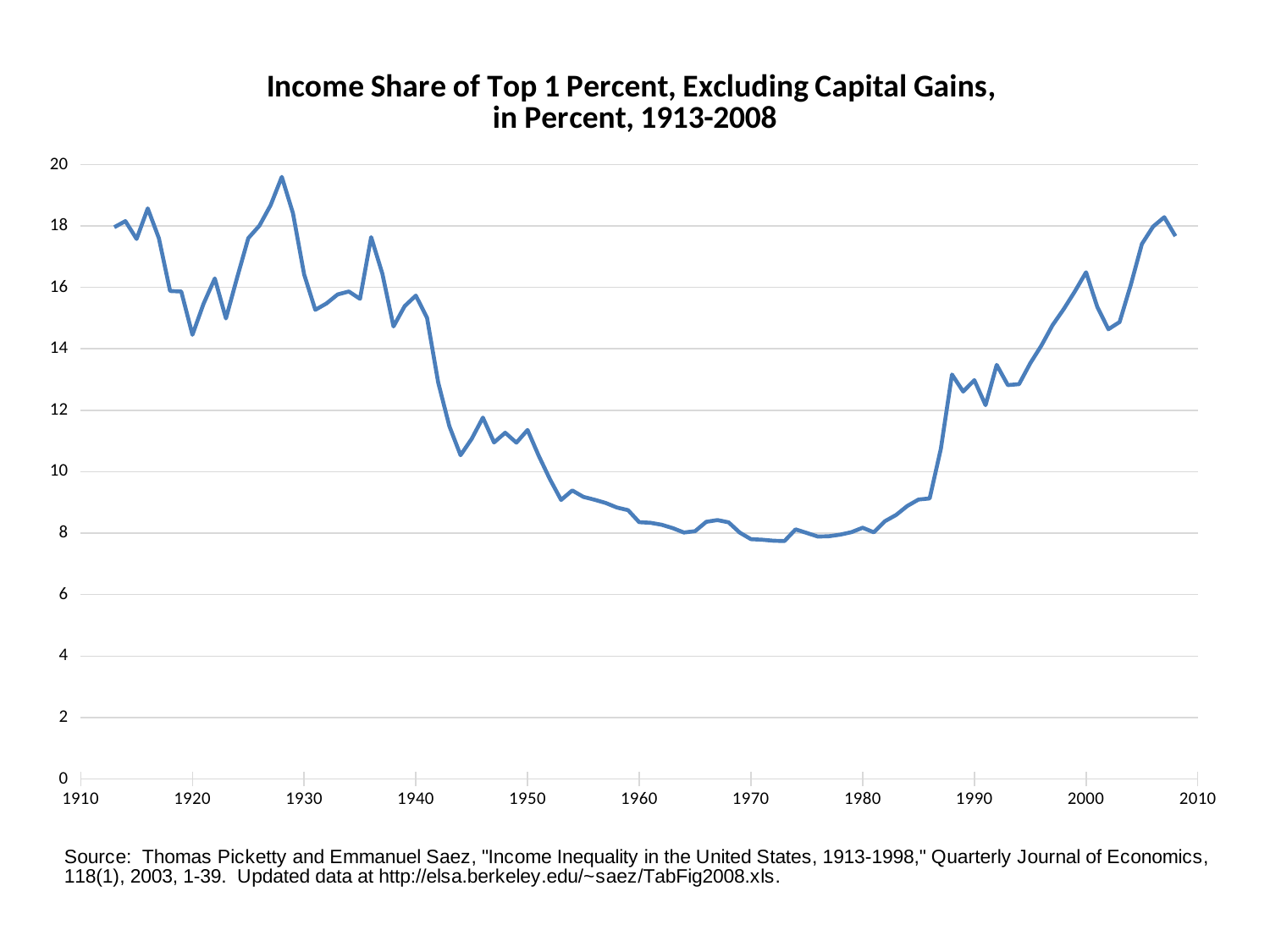
Is the value for 1960 greater or less than 10? less In which decade does the line reach its highest point? 1920s Does the income share rise or fall between 1940 and 1950? fall What kind of chart is shown on the slide? Line chart Does the income share rise or fall between 1980 and 2007? rise Which year has the larger value, 1920 or 1980? 1920 Is the value for 2000 greater or less than 14? greater Is the value for 1970 greater or less than 10? less What is the title of the chart? Income Share of Top 1 Percent, Excluding Capital Gains, in Percent, 1913-2008 What is the highest value shown on the vertical axis? 20